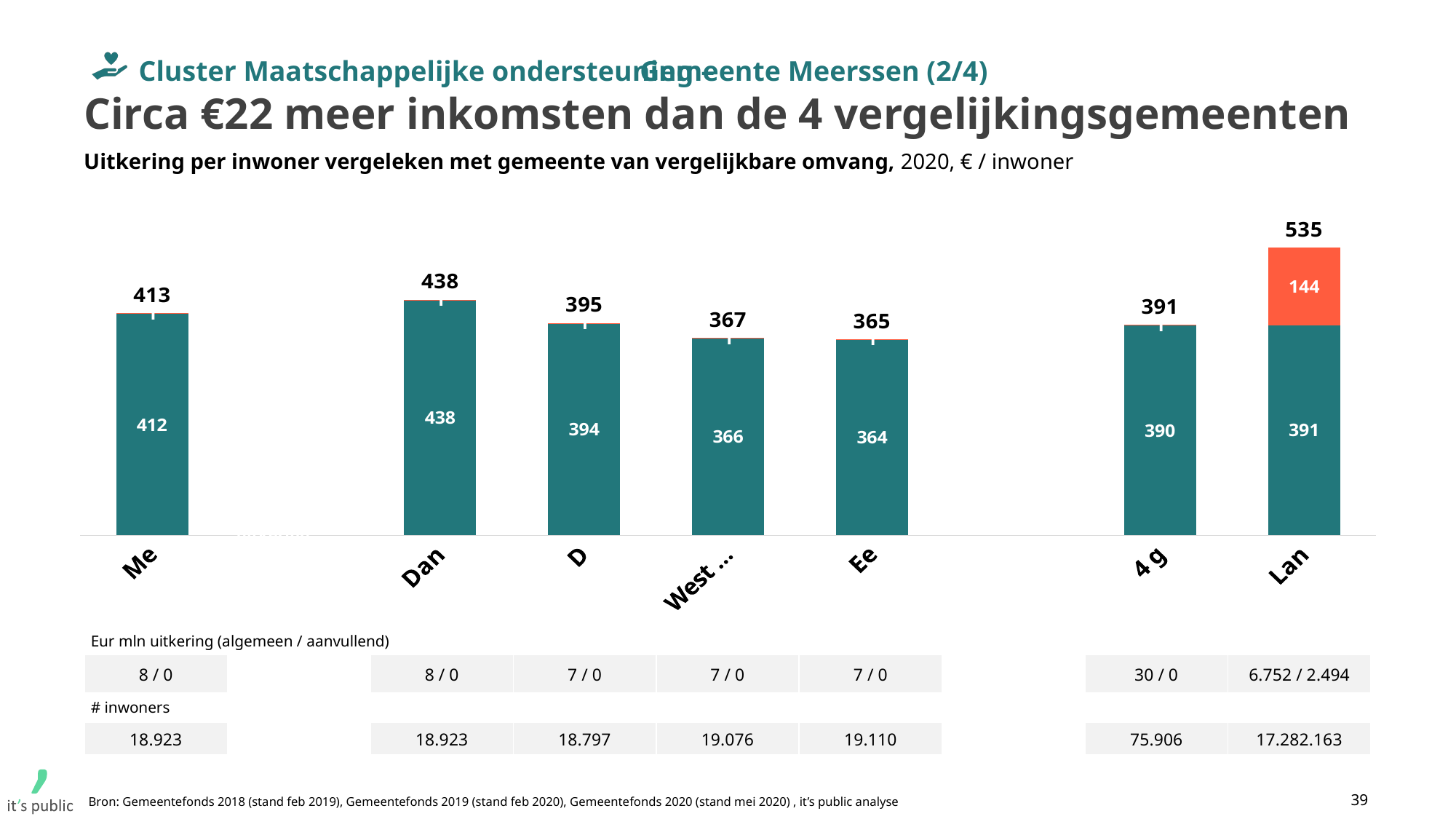
What is the sum of the two segments of the Lan bar (391 and 144)? 535 How many bars (categories) are plotted in the chart? 7 Which has a larger total value, Dan or D? Dan Which category has the lowest total value? Ee What is the value of the teal segment of the Dan bar? 438 What is the value of the orange (top) segment of the Lan bar? 144 What is the difference between the total for Me (413) and the total for 4 g (391)? 22 What unit is stated in the chart subtitle for the values? € / inwoner Which category has the highest total value? Lan What kind of chart is shown on the slide? Stacked bar chart What is the total value shown above the bar for Me? 413 What is the total value shown above the bar for Lan? 535